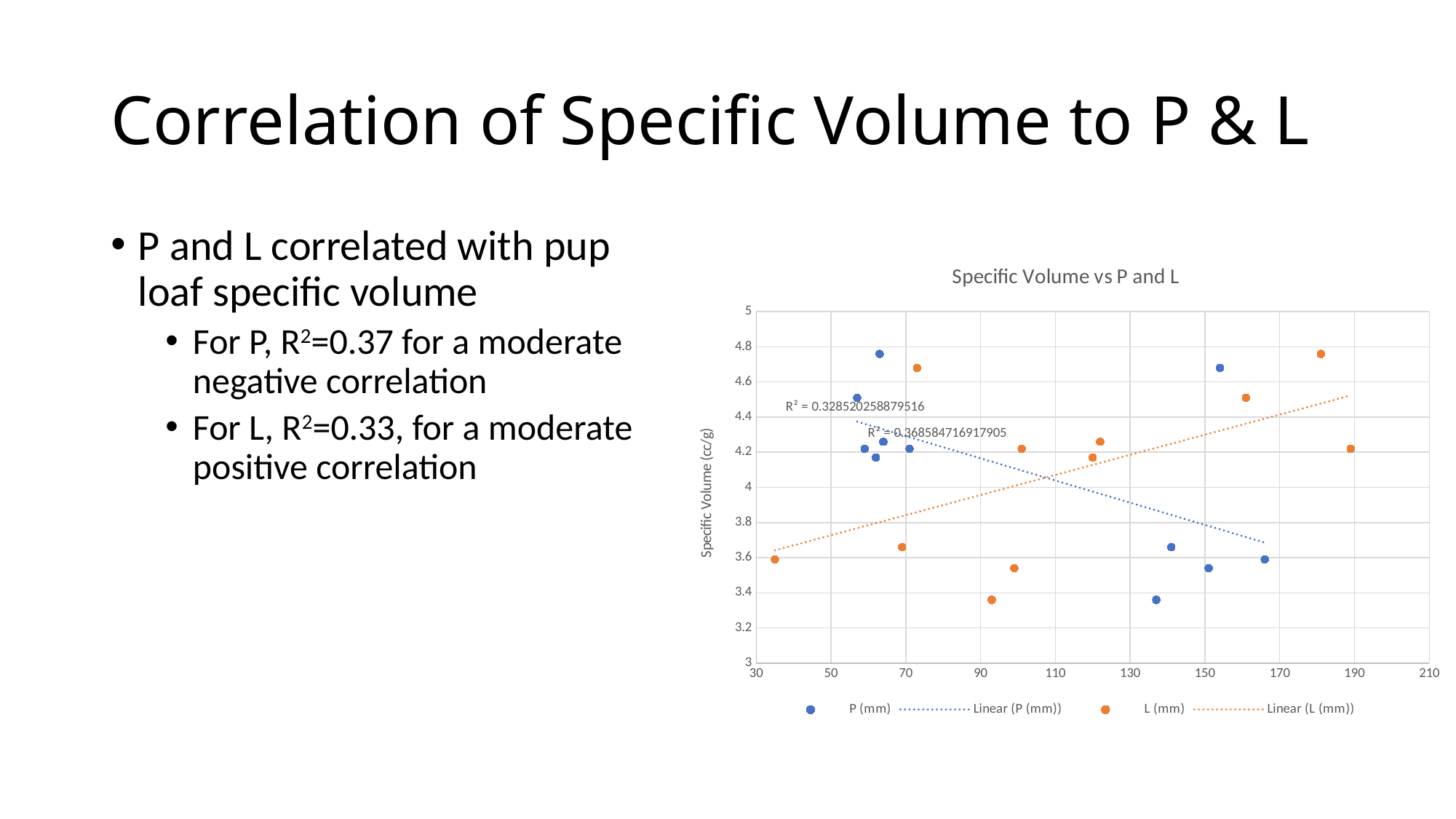
Is the lowest L (mm) point on the chart greater or less than 3.4 on the vertical axis? less Does the linear trendline for P (mm) rise or fall as the x-axis value increases? fall What is the title of the chart? Specific Volume vs P and L Is the highest P (mm) point on the chart greater or less than 4.6 on the vertical axis? greater Does the linear trendline for L (mm) rise or fall as the x-axis value increases? rise What R² value is printed on the chart for the blue (P) trendline? R² = 0.368584716917905 What kind of chart is shown on the slide? scatter chart What is the label of the vertical axis of the chart? Specific Volume (cc/g) What R² value is printed on the chart for the orange (L) trendline? R² = 0.328520258879516 How many entries does the chart legend list? 4 What is the maximum value shown on the horizontal axis of the chart? 210 Which series has the point farthest to the right on the x-axis, P (mm) or L (mm)? L (mm)